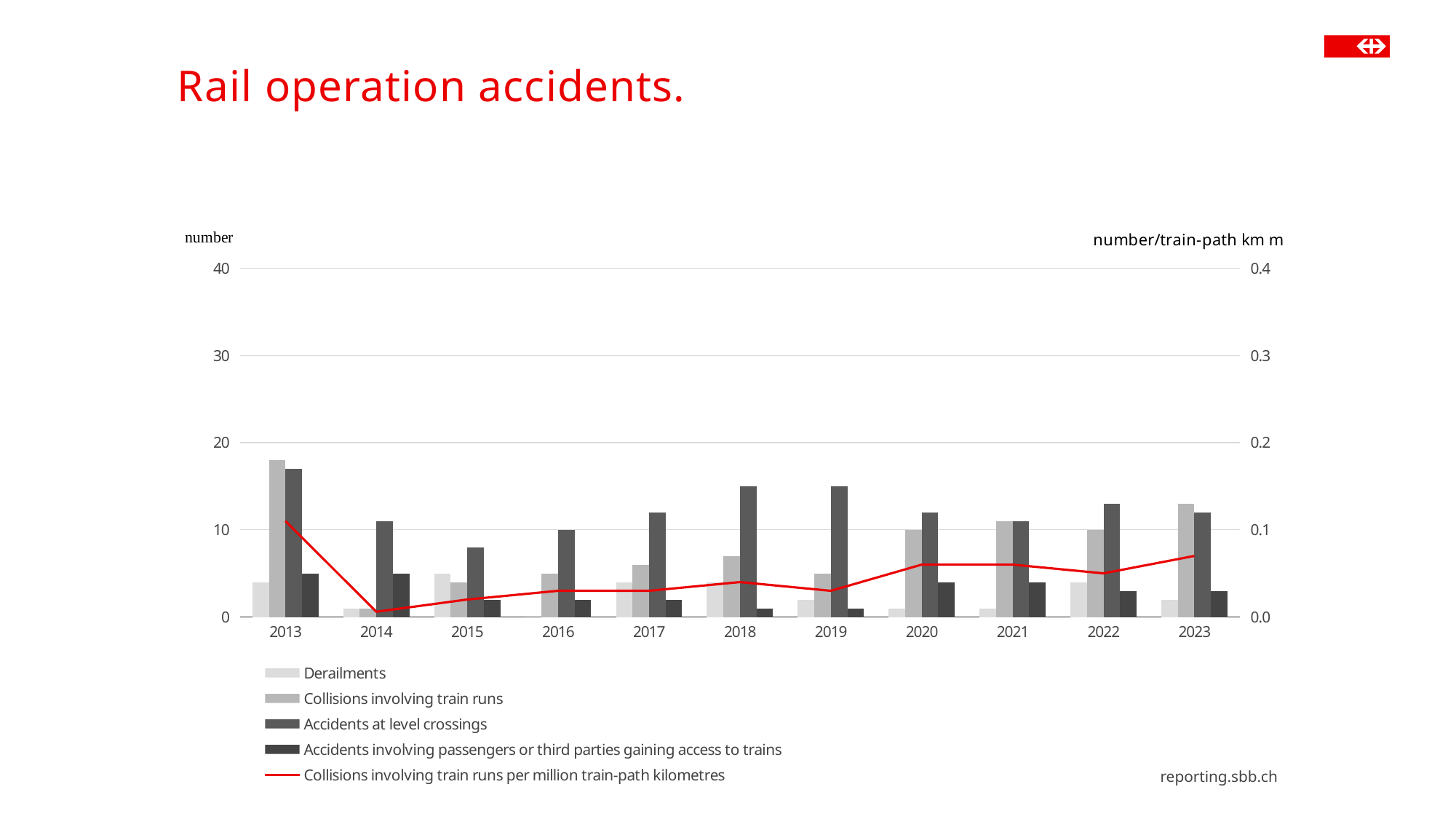
What is the label of the right-hand vertical axis? number/train-path km m Does the Collisions involving train runs per million train-path kilometres line rise or fall from 2013 to 2014? fall In 2018, which is larger: Accidents at level crossings or Collisions involving train runs? Accidents at level crossings In which year is the value for Accidents at level crossings lowest? 2015 Is the value for Accidents at level crossings in 2018 greater or less than 10? greater Is the value for Collisions involving train runs in 2013 greater or less than 10? greater In which year is the value for Accidents at level crossings highest? 2013 What kind of chart is shown on the slide? bar chart with a line In which year is the value for Collisions involving train runs highest? 2013 Is the value of the Collisions involving train runs per million train-path kilometres line in 2023 greater or less than 0.1? less How many series does the legend list? 5 How many years are shown on the x axis of the chart? 11